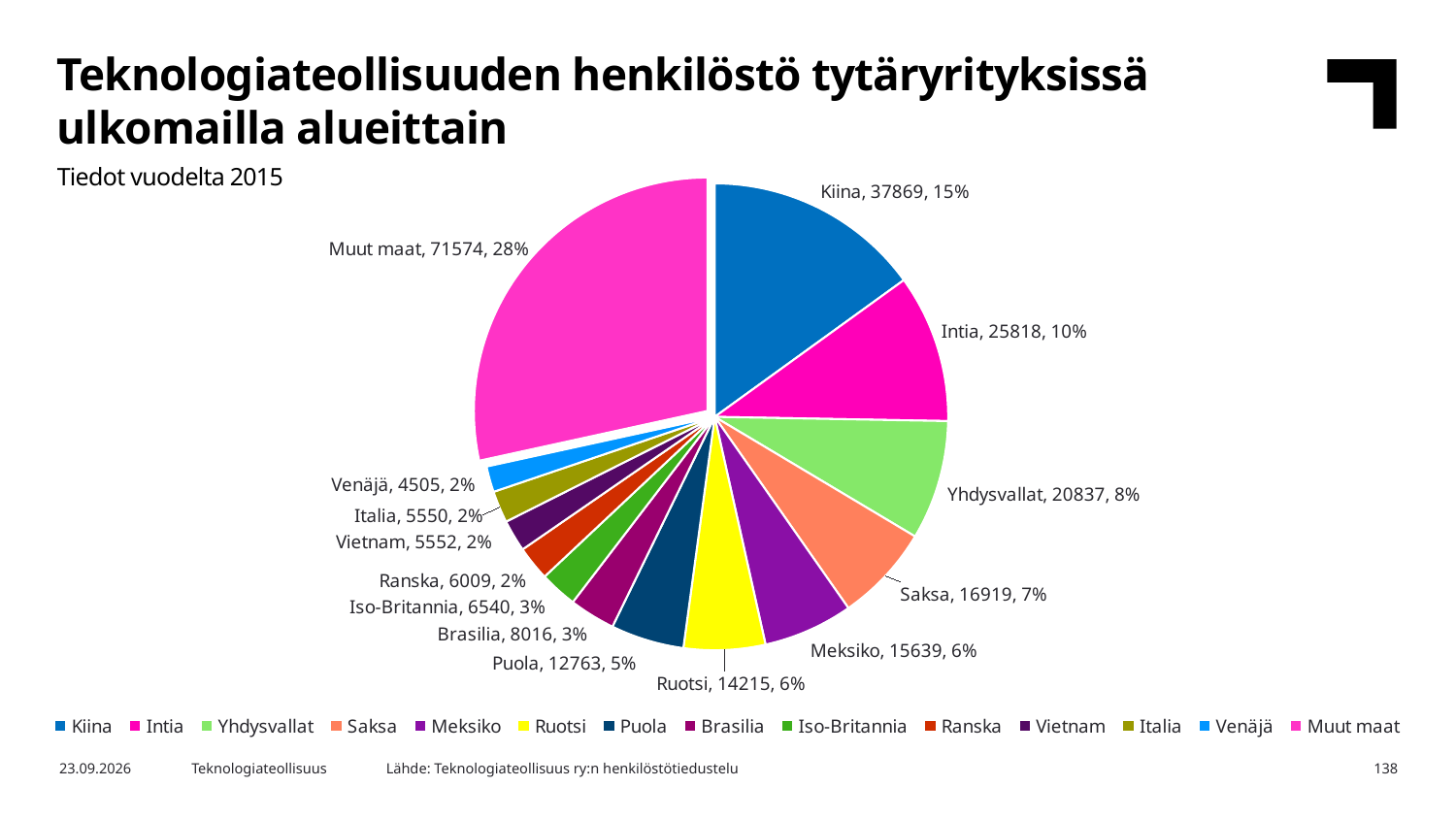
Which category has the largest slice? Muut maat Which category has the smallest slice? Venäjä What year do the data on the chart come from, according to the subtitle? 2015 How many slices does the pie chart have? 14 What is the difference between the values for Kiina and Intia? 12051 What is the value for Puola? 12763 What is the value for Saksa? 16919 What share of the pie does Yhdysvallat represent? 8% What is the value for Kiina? 37869 Which is larger, the value for Meksiko or the value for Ruotsi? Meksiko What share of the pie does Muut maat represent? 28% What kind of chart is shown on the slide? pie chart